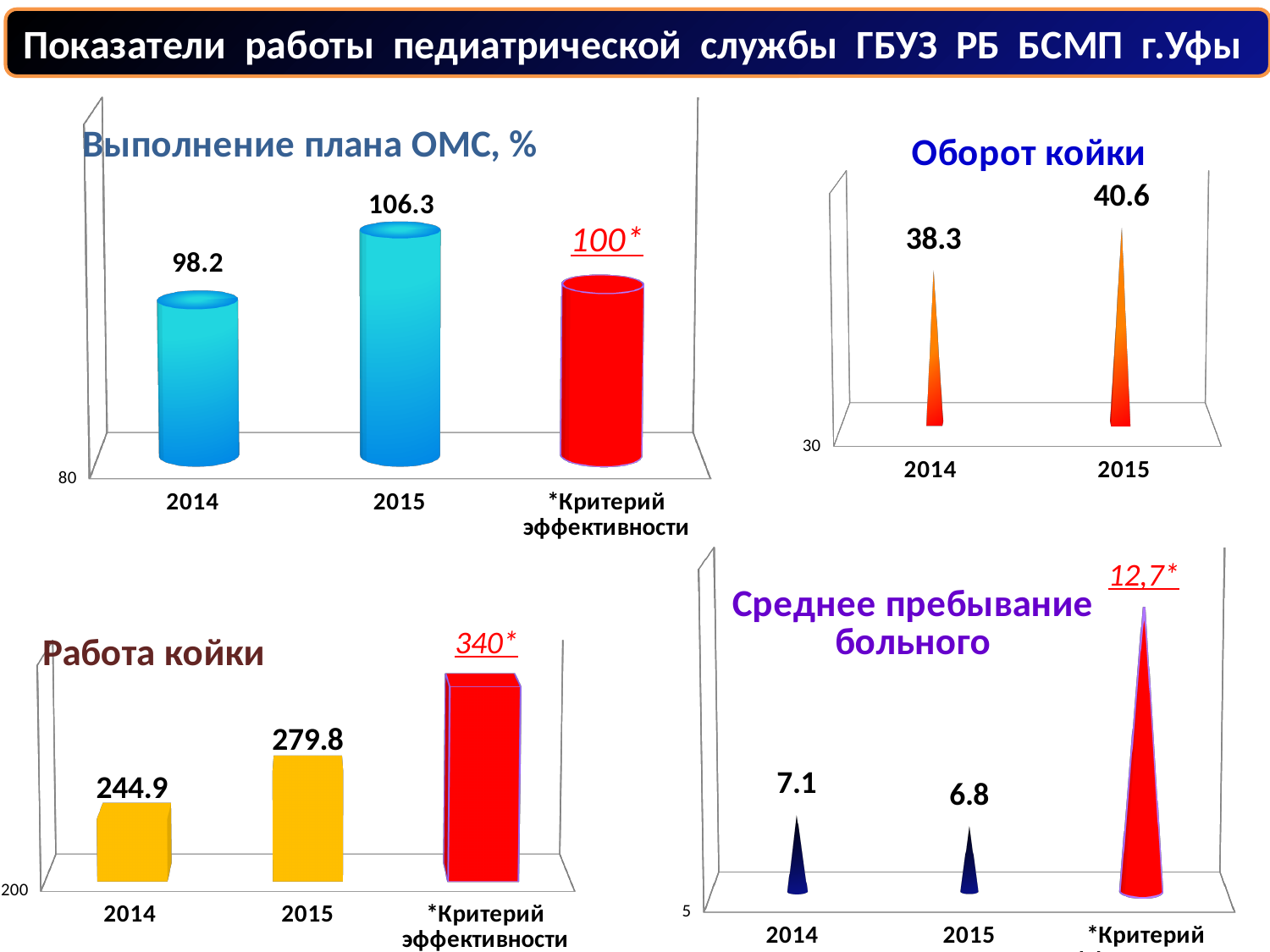
In the chart titled "Работа койки", what is the difference between the 2015 and 2014 values? 34.9 In the chart titled "Среднее пребывание больного", do the values rise or fall from 2014 to 2015? fall In the chart titled "Выполнение плана ОМС, %", what is the value shown for "*Критерий эффективности"? 100* In the chart titled "Работа койки", which category has the highest value? *Критерий эффективности In the chart titled "Выполнение плана ОМС, %", what is the value for 2014? 98.2 In the chart titled "Работа койки", what is the value for 2014? 244.9 In the chart titled "Оборот койки", how many categories are shown on the x axis? 2 In the chart titled "Выполнение плана ОМС, %", what is the value for 2015? 106.3 In the chart titled "Среднее пребывание больного", what is the value for 2015? 6.8 In the chart titled "Оборот койки", what is the difference between the 2015 and 2014 values? 2.3 In the chart titled "Среднее пребывание больного", which is larger, the value for 2014 or the value for 2015? 2014 In the chart titled "Оборот койки", what is the value for 2015? 40.6